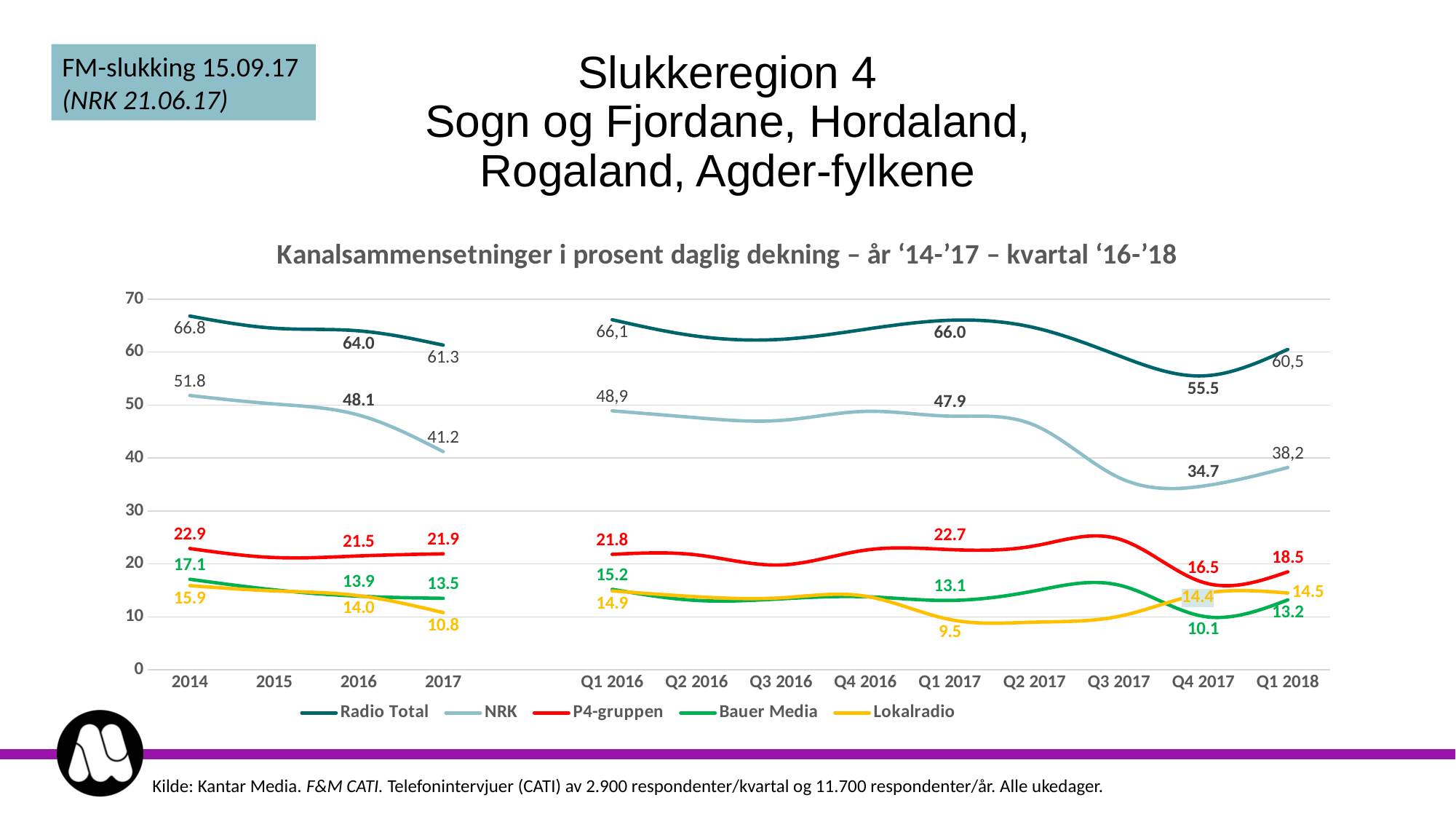
How many time points are labelled on the x axis? 13 What is the value for Lokalradio in Q1 2017? 9.5 Does the NRK line rise or fall from 2014 to 2017? Fall How many series does the legend list? 5 What is the value for P4-gruppen in Q1 2018? 18.5 What is the value for Radio Total in Q4 2017? 55.5 Which is larger in Q4 2017: Lokalradio or Bauer Media? Lokalradio What is the difference between the Radio Total values in 2014 and 2017? 5.5 What kind of chart is shown on the slide? Line chart Is the value for NRK in Q3 2017 greater or less than 40? less What is the value for NRK in 2017? 41.2 Which series is shown in red in the legend? P4-gruppen